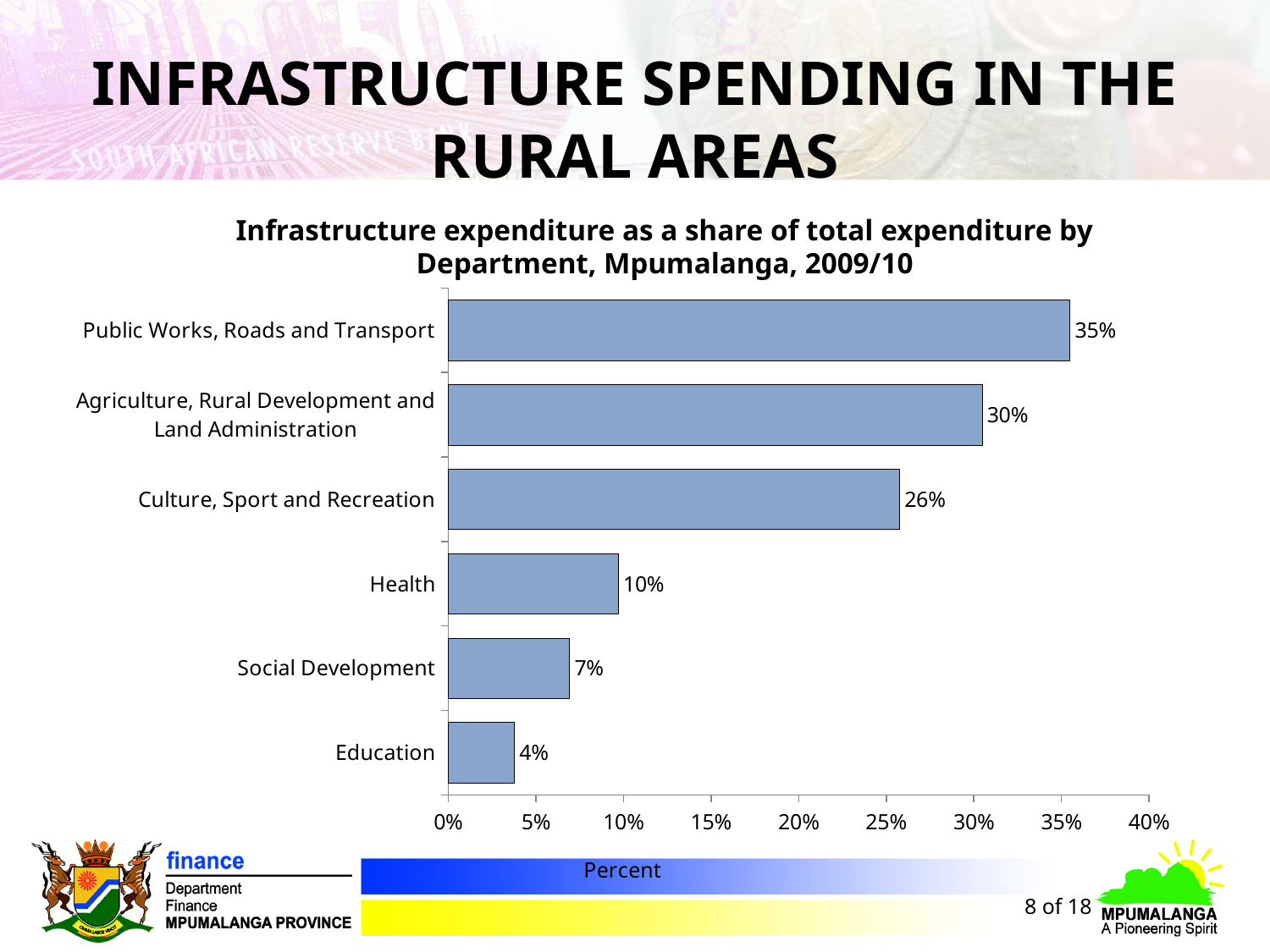
What is the value shown for Education? 4% What is the difference between the values for Culture, Sport and Recreation and Social Development? 19% How many departments are shown in the chart? 6 What is the title of the chart? Infrastructure expenditure as a share of total expenditure by Department, Mpumalanga, 2009/10 What is the value shown for Health? 10% What is the value shown for Agriculture, Rural Development and Land Administration? 30% What is the label on the horizontal axis of the chart? Percent Which department has the lowest infrastructure expenditure share? Education Which department has the highest infrastructure expenditure share? Public Works, Roads and Transport Which is larger, the value for Health or the value for Social Development? Health What is the infrastructure expenditure share for Public Works, Roads and Transport? 35% What kind of chart is shown on the slide? Bar chart